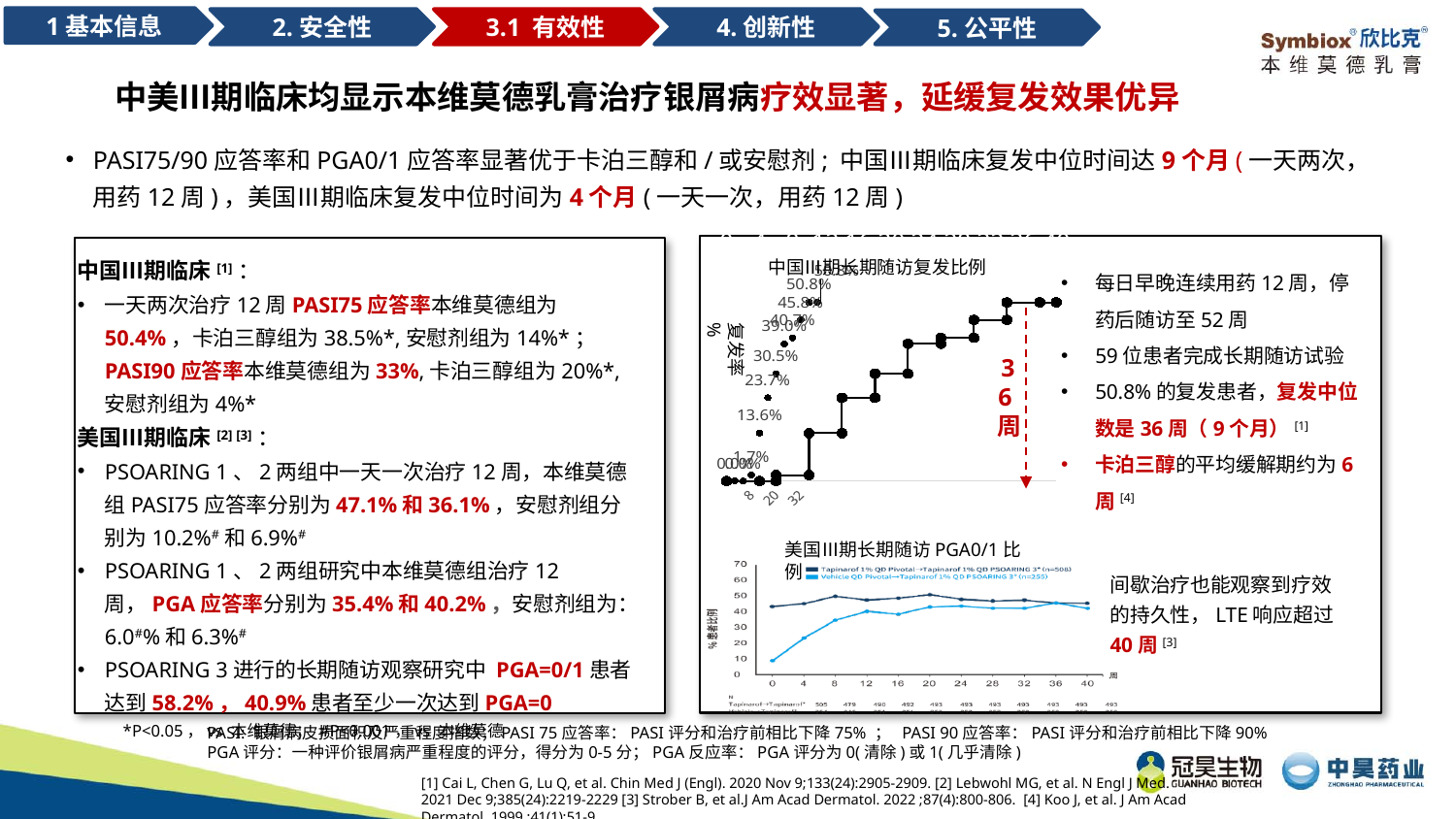
In the '中国III期长期随访复发比例' chart, at how many weeks is the dashed vertical marker annotated? 36周 What kind of chart is the '中国III期长期随访复发比例' chart? line chart In the '中国III期长期随访复发比例' chart, what is the lowest relapse rate value labelled? 0.0% What kind of chart is the '美国III期长期随访PGA0/1比例' chart? line chart In the '中国III期长期随访复发比例' chart, do the relapse rate values rise or fall along the x axis? rise In the '美国III期长期随访PGA0/1比例' chart, at week 4, which series has the higher value: the dark Tapinarof series or the blue Vehicle series? the dark Tapinarof series In the '美国III期长期随访PGA0/1比例' chart, is the value of the dark (Tapinarof 1% QD Pivotal) series at week 0 greater or less than 30? greater In the '美国III期长期随访PGA0/1比例' chart, what is the maximum value shown on the y axis? 70 In the '中国III期长期随访复发比例' chart, what is the highest relapse rate value labelled? 50.8% In the '美国III期长期随访PGA0/1比例' chart, how many series does the legend list? 2 In the '美国III期长期随访PGA0/1比例' chart, is the value of the blue (Vehicle QD Pivotal) series at week 0 greater or less than 30? less In the '美国III期长期随访PGA0/1比例' chart, how many week tick marks are shown on the x axis? 11